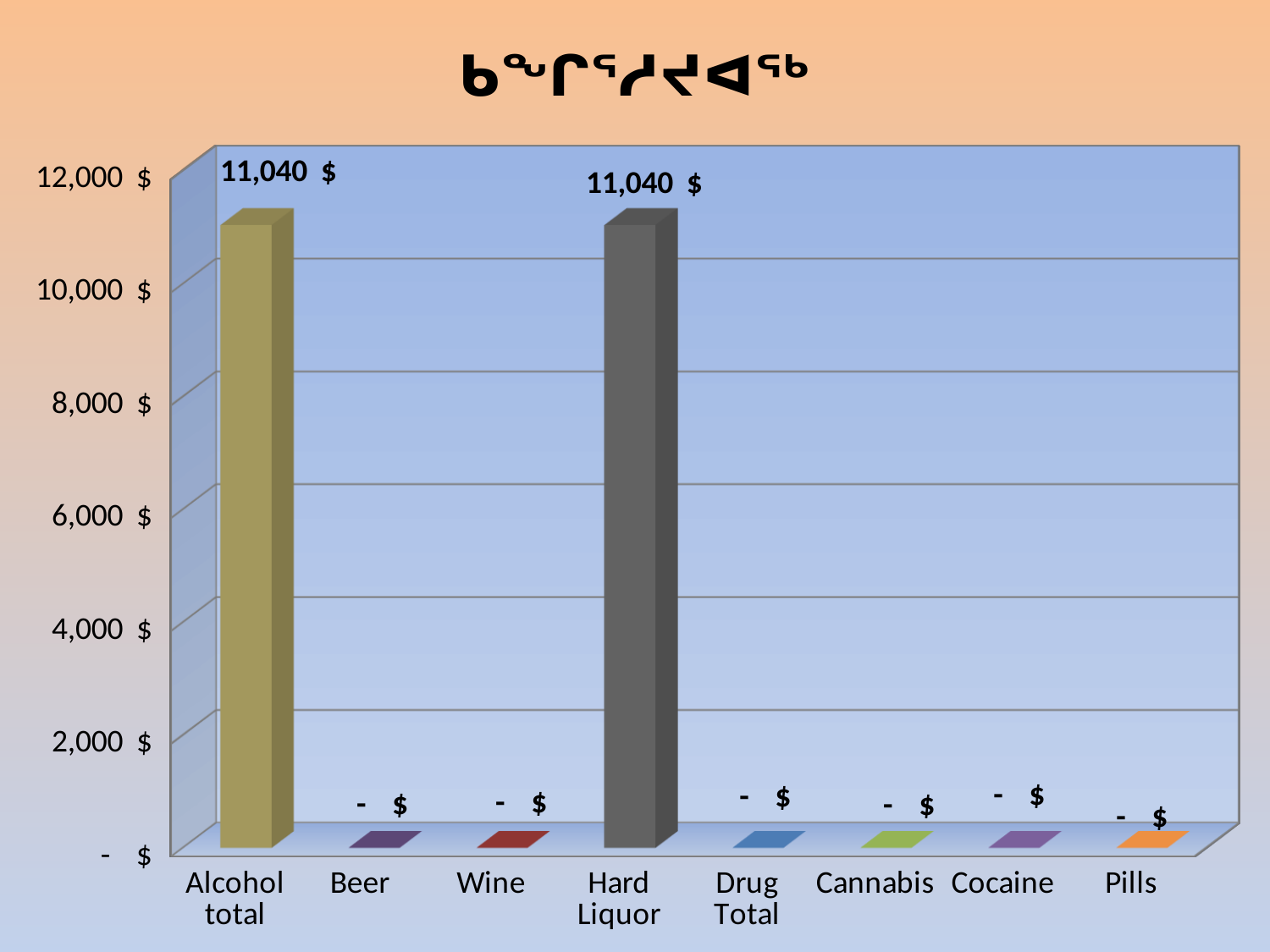
What is the value for Alcohol total? 11,040 $ Which categories have a value of 11,040 $? Alcohol total and Hard Liquor Is the value for Alcohol total greater or less than 10,000 $? greater What is the difference between the value for Alcohol total and the value for Hard Liquor? 0 $ Is the value for Hard Liquor greater or less than 12,000 $? less How many categories are shown on the x axis? 8 What is the value shown for Beer? - $ What is the value shown for Drug Total? - $ What kind of chart is shown on the slide? Bar chart What colour is the bar for Hard Liquor? Dark grey What is the value for Hard Liquor? 11,040 $ Which is larger, the value for Hard Liquor or the value for Cannabis? Hard Liquor